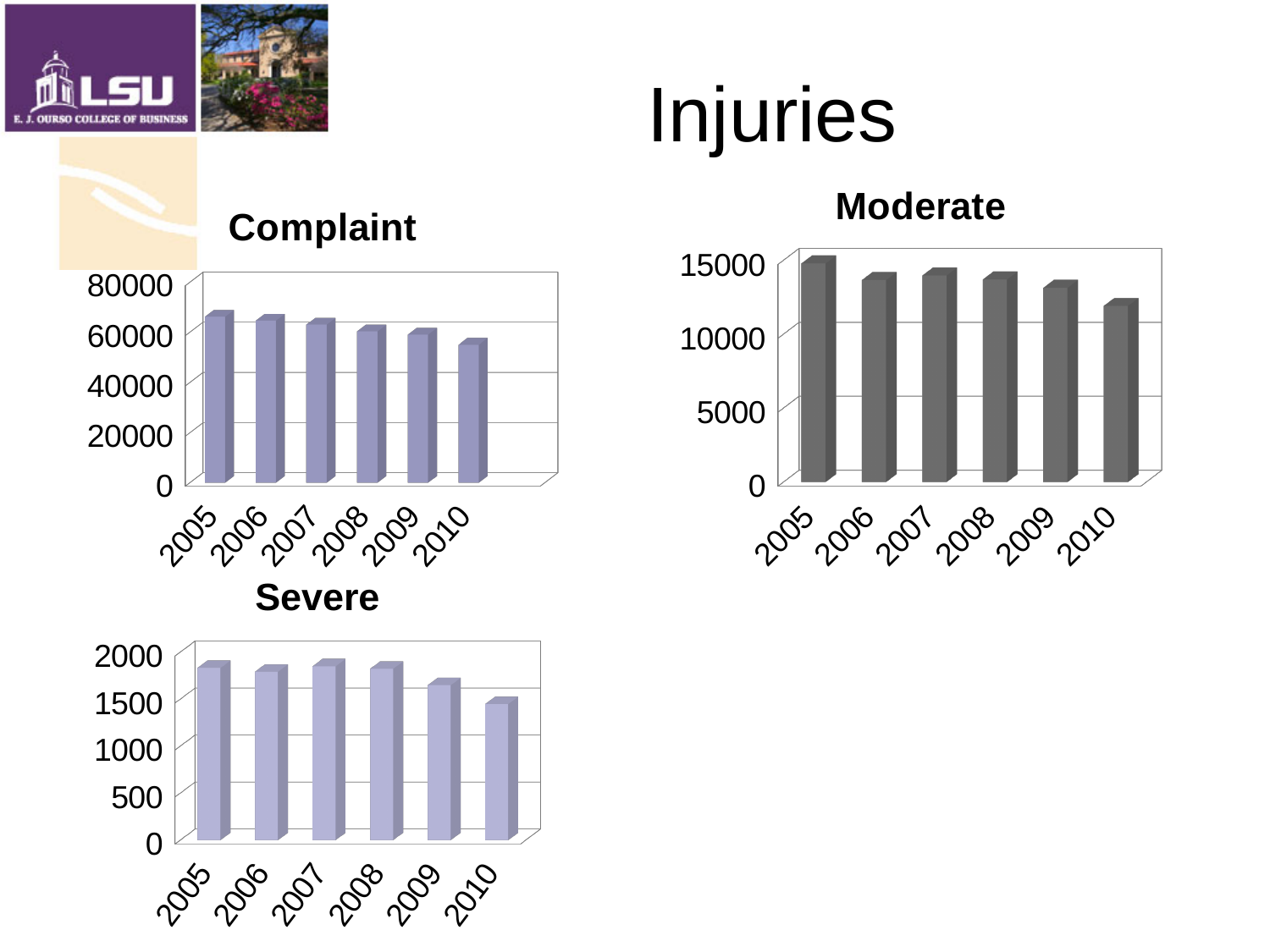
In the Moderate chart, is the value for 2010 greater or less than 10000? greater In the Complaint chart, which year has the lowest value? 2010 How many charts are shown on the slide, and what type are they? Three bar charts In the Moderate chart, which year has the highest value? 2005 In the Severe chart, which year has the lowest value? 2010 In the Moderate chart, which is larger, the value for 2005 or the value for 2010? 2005 In the Severe chart, is the value for 2009 greater or less than 1500? greater In the Complaint chart, which year has the highest value? 2005 In the Complaint chart, is the value for 2010 greater or less than 60000? less In the Complaint chart, do the values rise or fall from 2005 to 2010? fall In the Moderate chart, which year has the lowest value? 2010